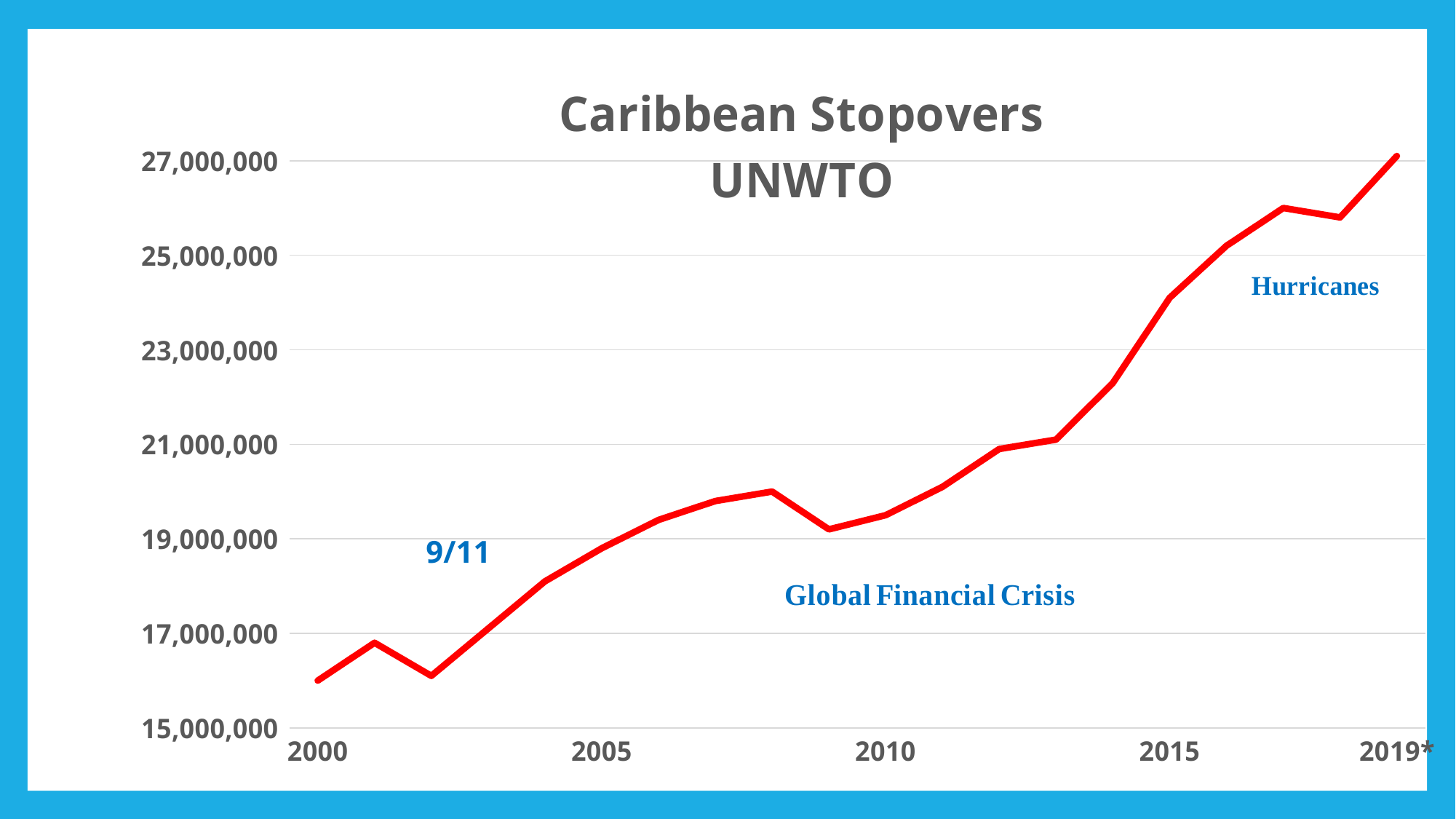
Is the value for 2010 greater or less than 19,000,000? greater Is the value for 2000 greater or less than 17,000,000? less Which year has the larger value, 2017 or 2018? 2017 What is the title of the chart? Caribbean Stopovers UNWTO Is the value for 2009 greater or less than 21,000,000? less Overall, do the values rise or fall from 2000 to 2019*? rise Which year has the larger value, 2008 or 2009? 2008 What kind of chart is shown on the slide? line chart Which event is annotated on the chart near the dip around 2009? Global Financial Crisis Which year has the highest value on the chart? 2019*